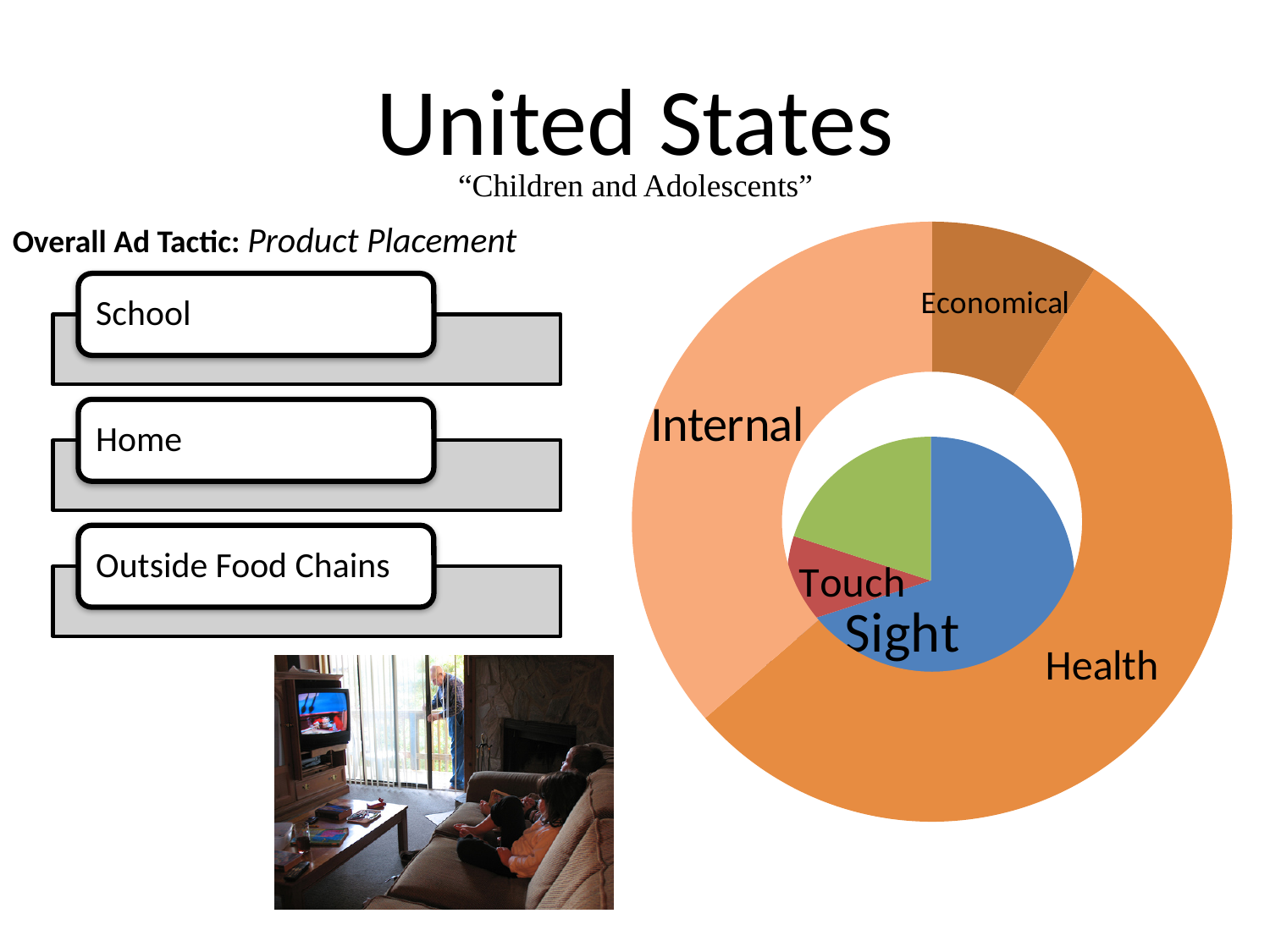
In the outer ring chart, which segment is the largest? Health What kind of chart is the small chart in the centre of the ring on the right? pie chart In the outer ring chart, which segment is the smallest? Economical What colour is the Sight slice in the inner pie chart? blue In the inner pie chart, which labelled slice is the largest? Sight In the outer ring chart, which segment is larger, Internal or Economical? Internal What kind of chart is the outer ring on the right side of the slide? doughnut chart How many slices does the inner pie chart have? 3 In the outer ring chart, which segment is larger, Health or Internal? Health How many labelled segments does the outer ring chart have? 3 In the inner pie chart, which labelled slice is the smallest? Touch In the inner pie chart, which slice is larger, Sight or Touch? Sight